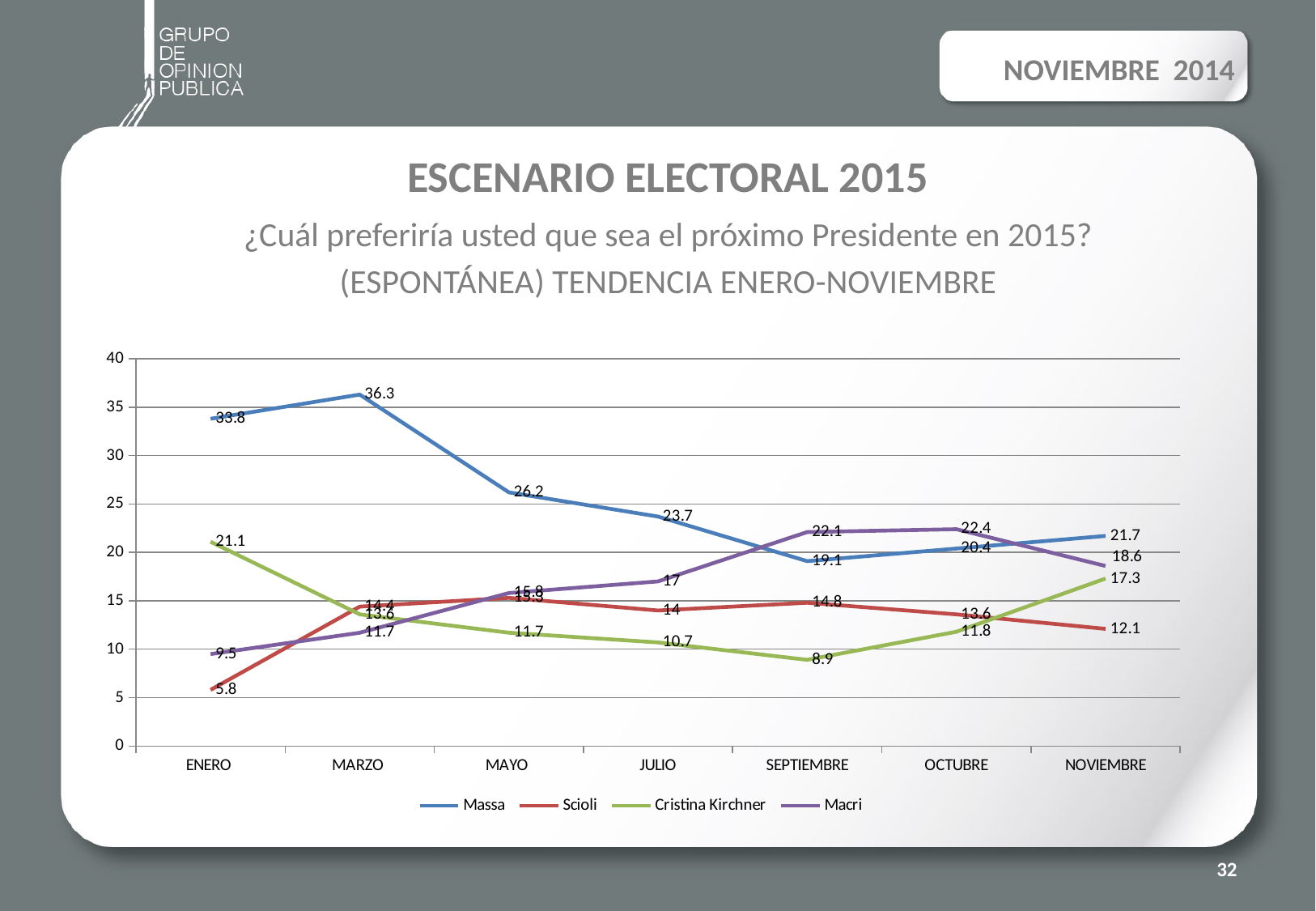
What is the value for Macri in OCTUBRE? 22.4 What kind of chart is shown on the slide? Line chart What is the difference between Massa's value in ENERO and in NOVIEMBRE? 12.1 What is the value for Massa in MARZO? 36.3 In which month does Cristina Kirchner have her lowest value? SEPTIEMBRE Is the value for Massa in SEPTIEMBRE greater or less than 20? less How many months are shown on the x axis? 7 What is the value for Scioli in ENERO? 5.8 What is the value for Cristina Kirchner in SEPTIEMBRE? 8.9 In NOVIEMBRE, which is larger: the value for Macri or the value for Cristina Kirchner? Macri How many series does the legend list? 4 In which month does Massa reach its highest value? MARZO